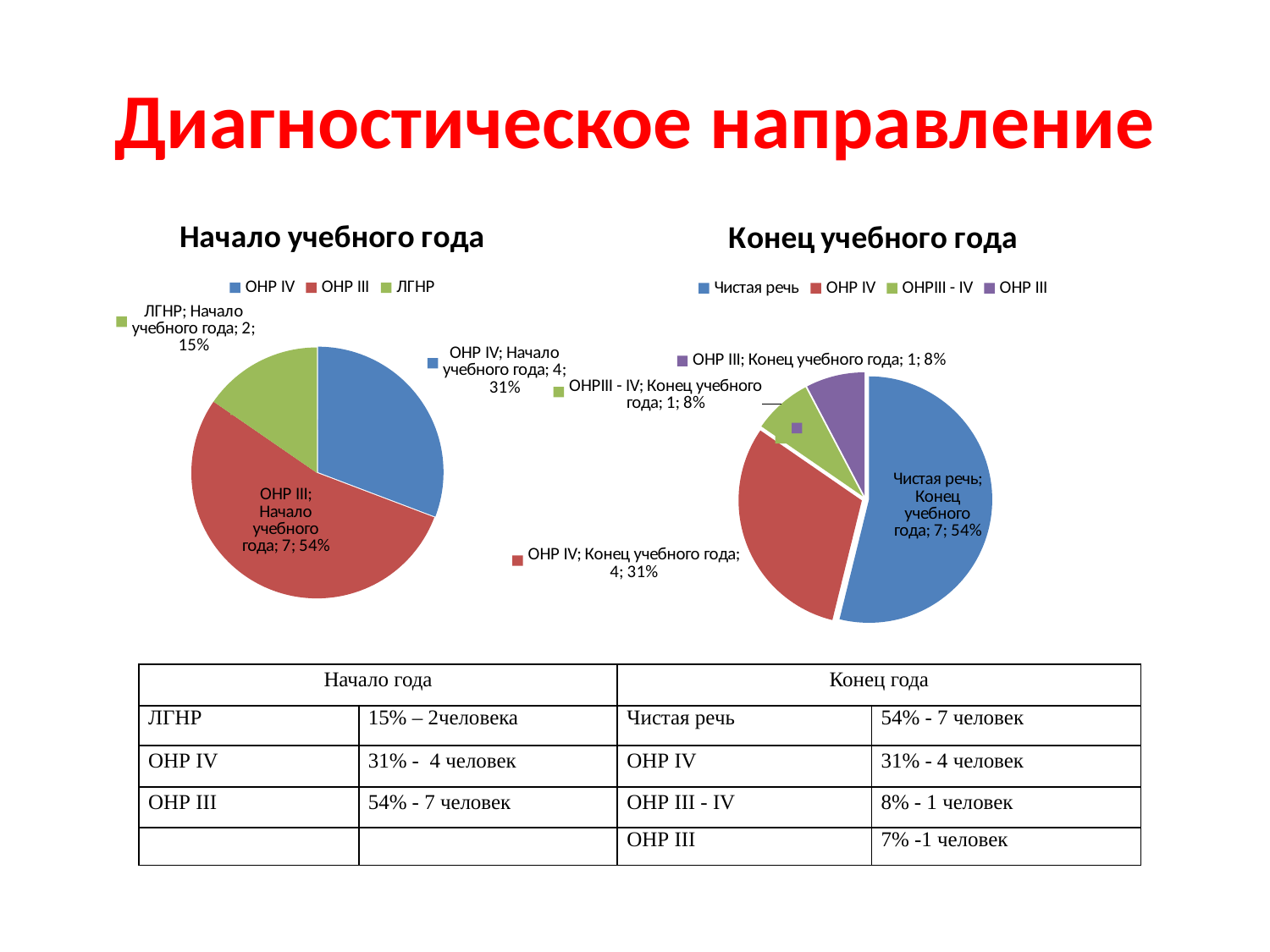
In the "Конец учебного года" chart, which category has the largest slice? Чистая речь In the "Начало учебного года" chart, what is the difference between the values for ОНР III and ОНР IV? 3 In the "Конец учебного года" chart, what percentage share does ОНР IV have? 31% In the "Конец учебного года" chart, what is the value for Чистая речь? 7 What kind of chart is "Начало учебного года"? pie chart In the "Конец учебного года" chart, which is larger: the value for ОНР IV or the value for ОНР III? ОНР IV In the "Начало учебного года" chart, which category has the largest slice? ОНР III How many categories does the "Конец учебного года" chart show? 4 How many categories does the "Начало учебного года" chart show? 3 In the "Начало учебного года" chart, which category has the smallest slice? ЛГНР In the "Начало учебного года" chart, what is the value for ЛГНР? 2 In the "Начало учебного года" chart, what percentage share does ОНР III have? 54%